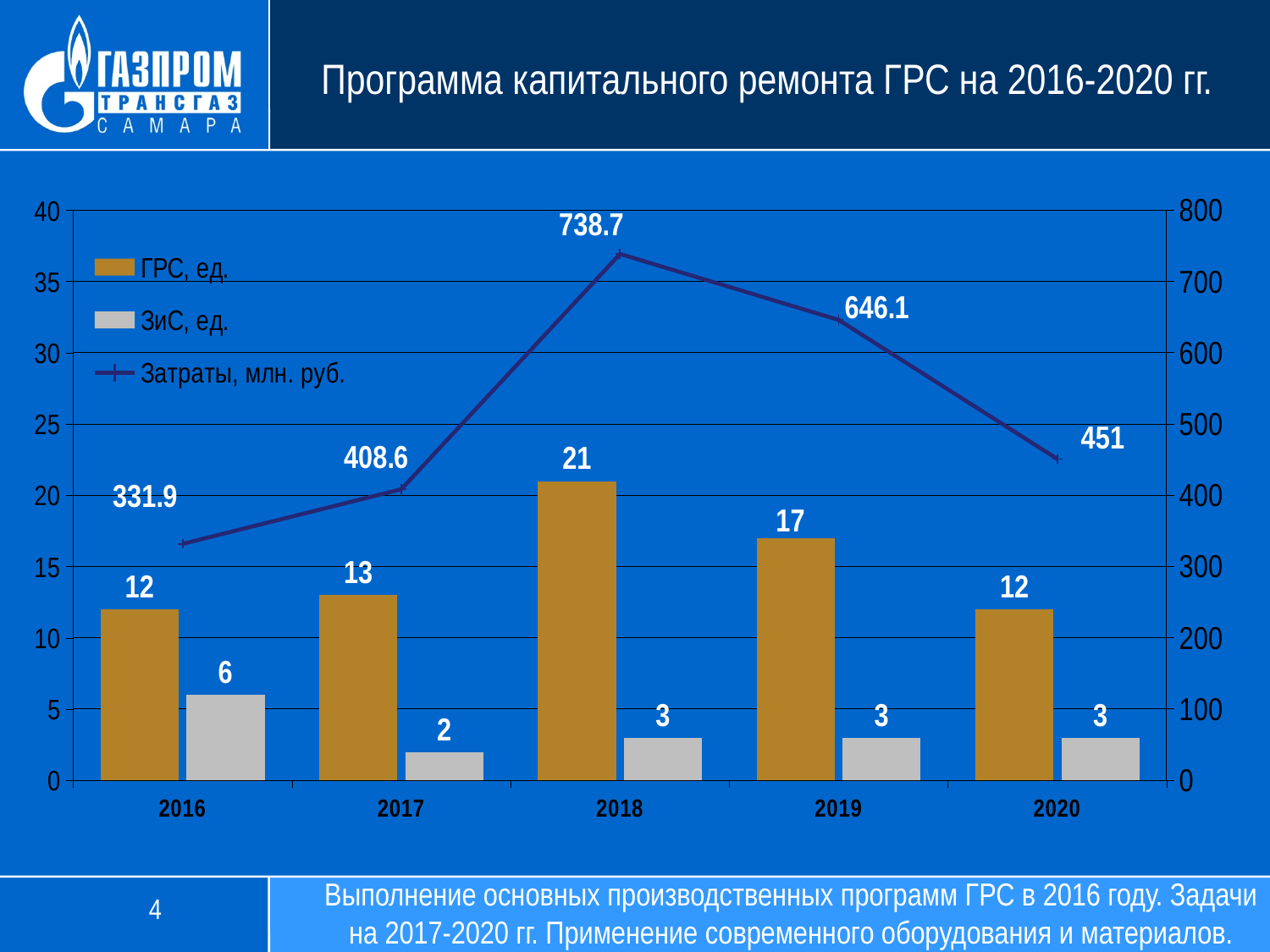
Which is larger: Затраты, млн. руб. in 2017 or in 2020? 2020 How many series does the legend list? 3 What is the difference between Затраты, млн. руб. in 2018 and in 2016? 406.8 What is the value of Затраты, млн. руб. for 2019? 646.1 What is the difference between ГРС, ед. in 2018 and in 2019? 4 What is the value of ГРС, ед. for 2018? 21 In which year is Затраты, млн. руб. highest? 2018 What kind of chart is this? Combined bar and line chart What is the value of ЗиС, ед. for 2016? 6 How many years are shown on the x axis? 5 In which year is ЗиС, ед. lowest? 2017 Does Затраты, млн. руб. rise or fall from 2018 to 2020? fall